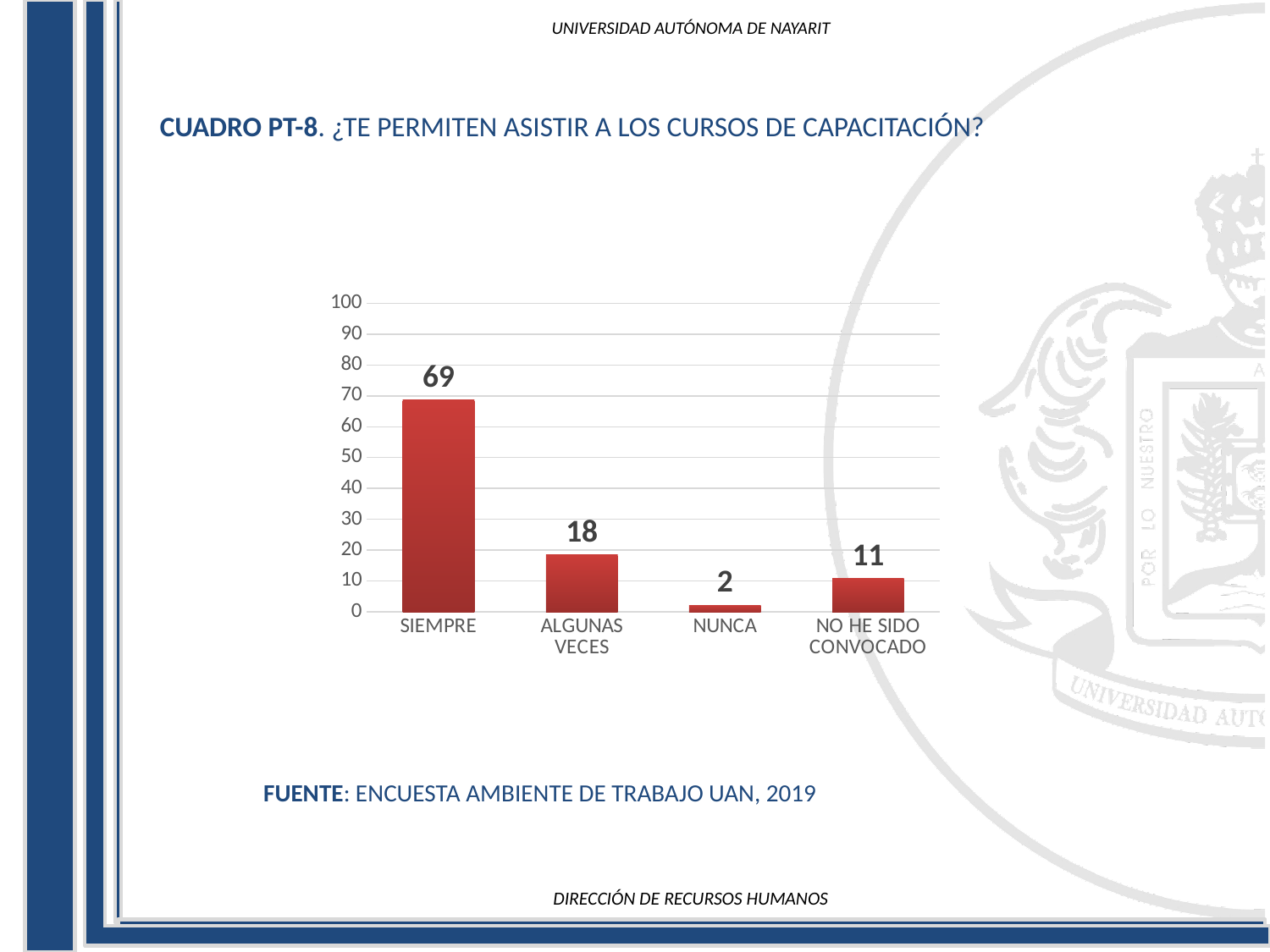
Which category has the highest value? SIEMPRE What is the maximum value shown on the vertical axis? 100 What is the value for NO HE SIDO CONVOCADO? 11 What is the difference between the values for SIEMPRE and ALGUNAS VECES? 51 What is the value for SIEMPRE? 69 What is the difference between the values for ALGUNAS VECES and NO HE SIDO CONVOCADO? 7 Which category has the lowest value? NUNCA How many categories are shown on the x axis? 4 What is the value for ALGUNAS VECES? 18 Which is larger, the value for NO HE SIDO CONVOCADO or the value for NUNCA? NO HE SIDO CONVOCADO What is the value for NUNCA? 2 What kind of chart is shown on the slide? Bar chart